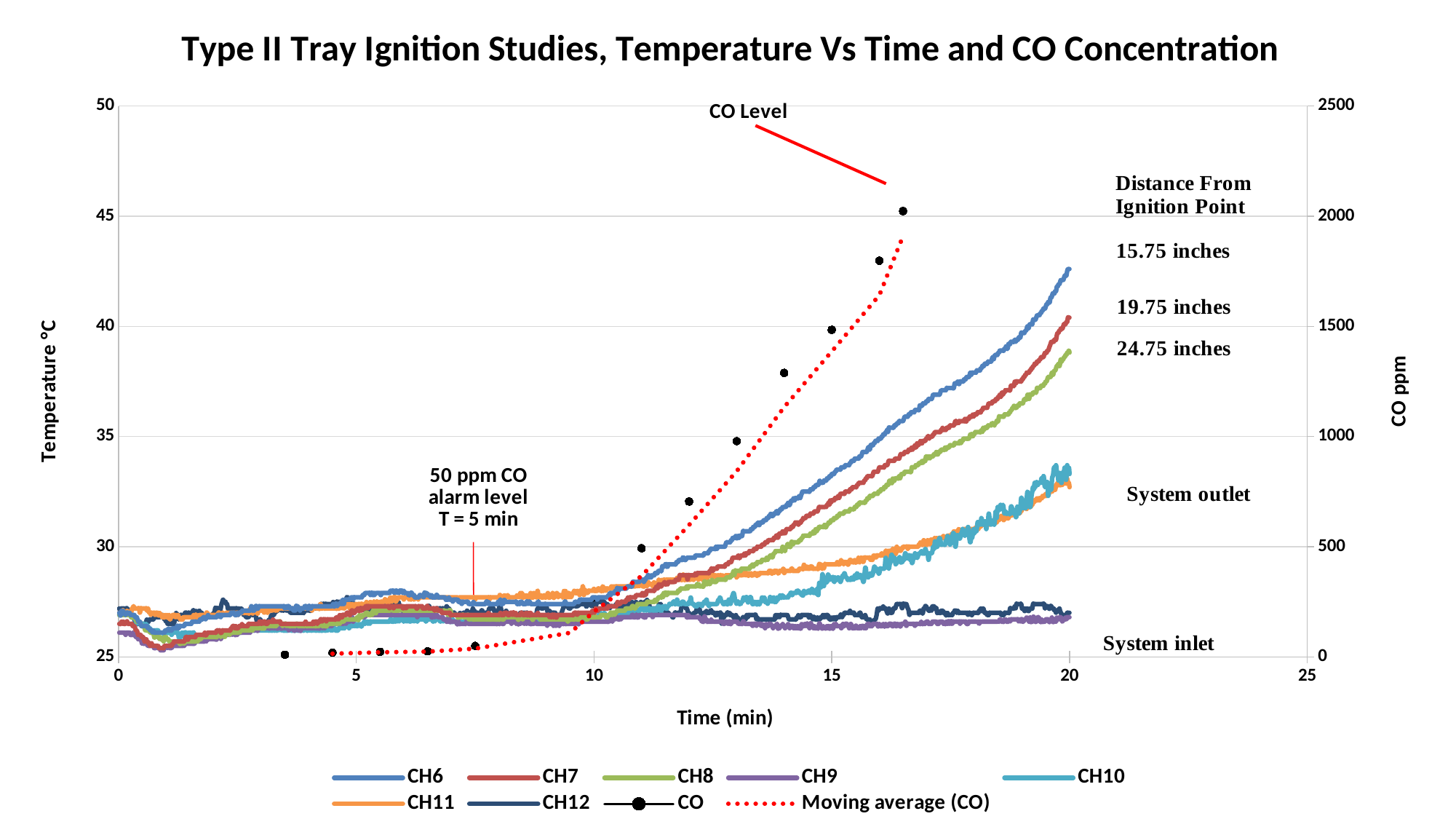
Which series reaches the highest temperature at 20 minutes? CH6 What is the label of the right-hand vertical axis? CO ppm What type of chart is shown on the slide? line chart Is the CO value at 12 minutes greater or less than 500 ppm? greater How many series does the legend list? 9 What is the title of the chart? Type II Tray Ignition Studies, Temperature Vs Time and CO Concentration Is the temperature of CH8 at 20 minutes greater or less than 40 °C? less Is the temperature of CH9 at 20 minutes greater or less than 30 °C? less Does the CH6 temperature rise or fall between 10 and 20 minutes? rise At 20 minutes, which is higher: CH6 or CH8? CH6